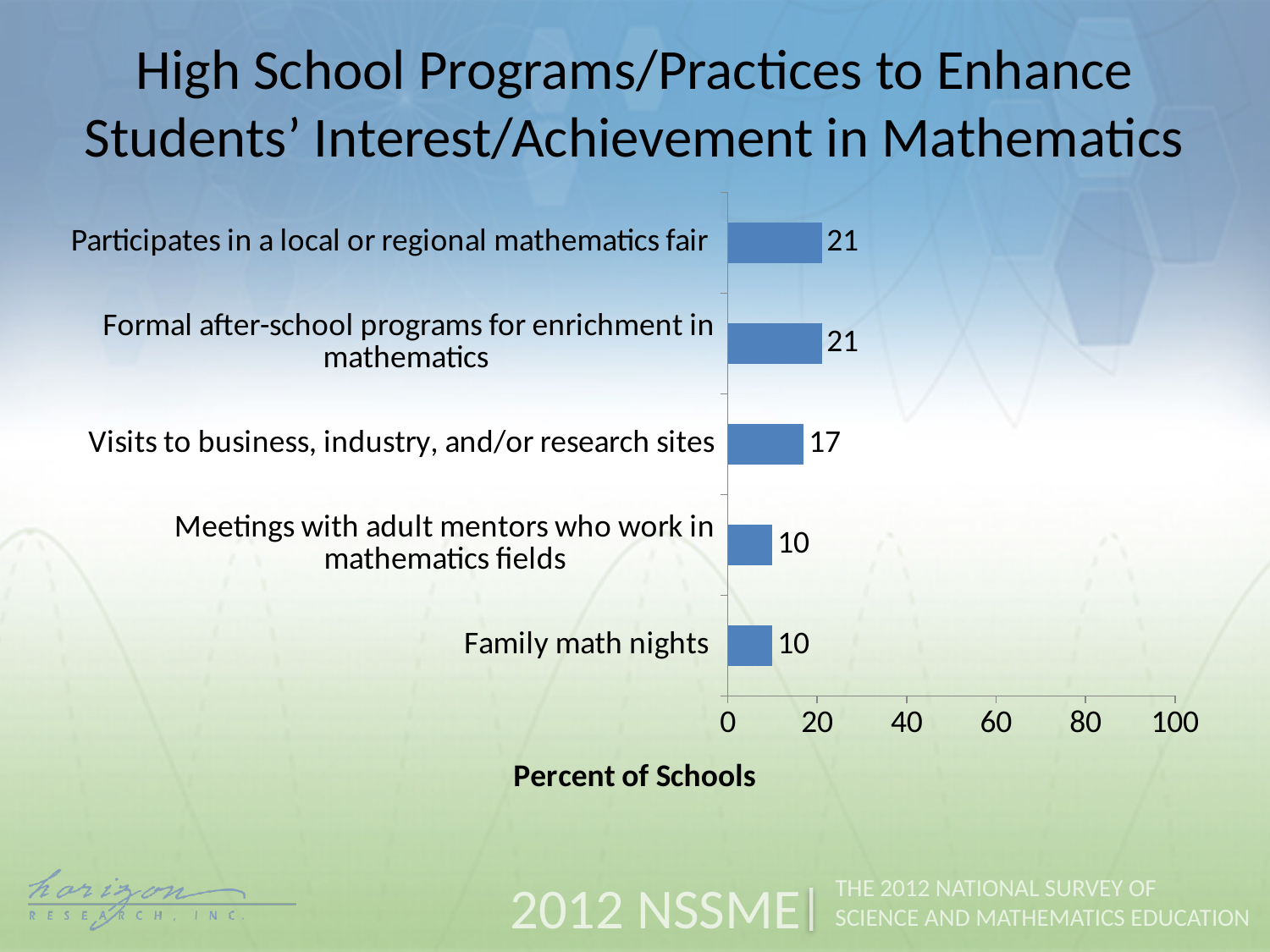
What percent of schools have family math nights? 10 What is the difference between the value for Visits to business, industry, and/or research sites and the value for Meetings with adult mentors who work in mathematics fields? 7 Is the value for Participates in a local or regional mathematics fair greater or less than 40? less Which category has the lowest value, Visits to business, industry, and/or research sites or Family math nights? Family math nights What kind of chart is shown on the slide? bar chart What is the value for Visits to business, industry, and/or research sites? 17 What is the value for Meetings with adult mentors who work in mathematics fields? 10 How many categories are shown in the chart? 5 What is the difference between the value for Formal after-school programs for enrichment in mathematics and the value for Family math nights? 11 What percent of schools participate in a local or regional mathematics fair? 21 What is the label of the horizontal axis? Percent of Schools What is the maximum value shown on the horizontal axis? 100